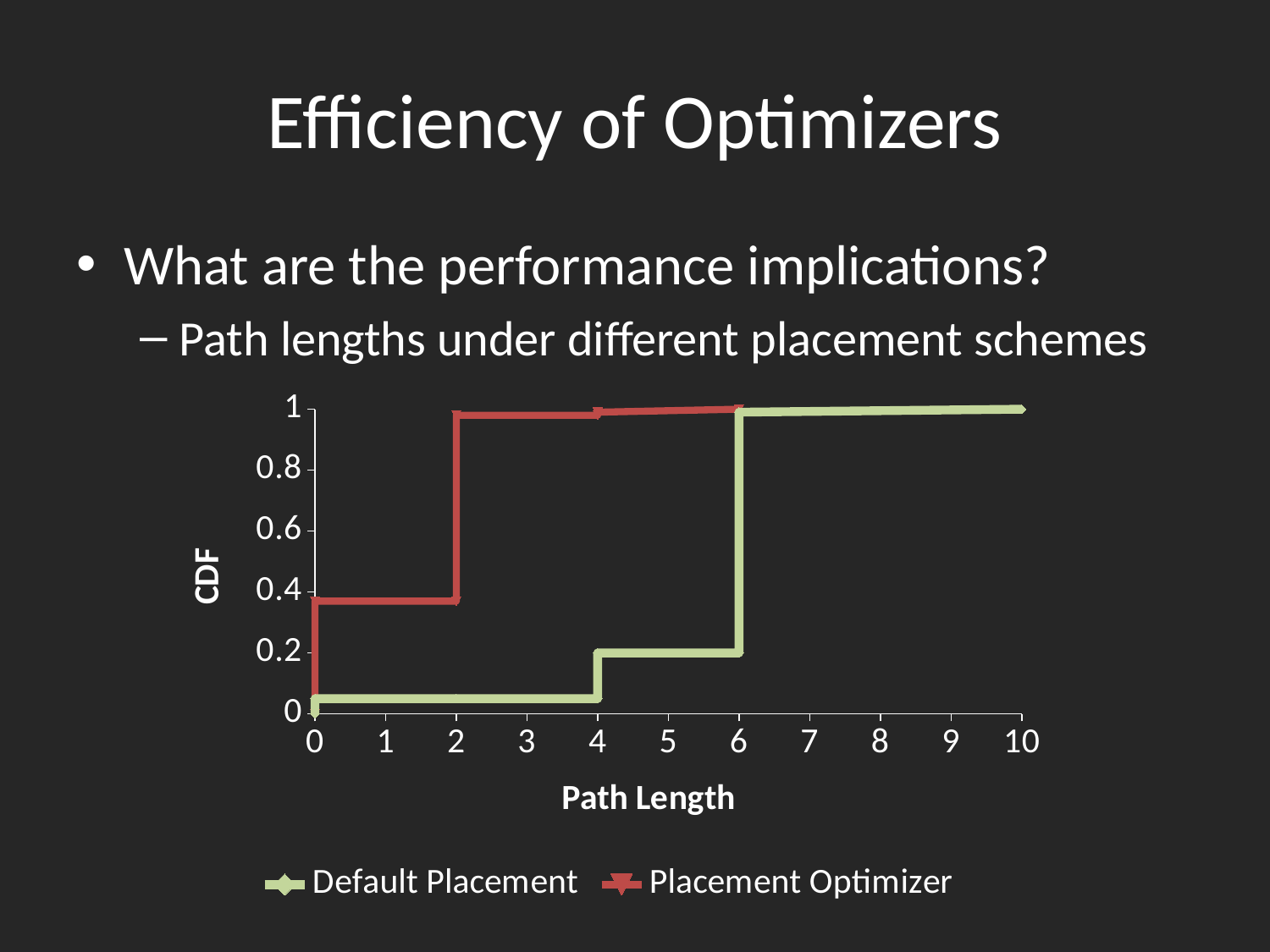
At a path length of 3, is the CDF for Placement Optimizer greater or less than 0.8? greater At a path length of 3, is the CDF for Default Placement greater or less than 0.2? less What is the label of the x axis? Path Length How many series does the legend list? 2 What is the largest path length value shown on the x axis? 10 What kind of chart is shown on the slide? line chart At a path length of 1, is the CDF for Placement Optimizer greater or less than 0.2? greater What is the label of the y axis? CDF Does the CDF for Default Placement rise or fall as path length increases? rise What CDF value does the Default Placement series reach at a path length of 10? 1 At a path length of 1, which series has the higher CDF, Default Placement or Placement Optimizer? Placement Optimizer